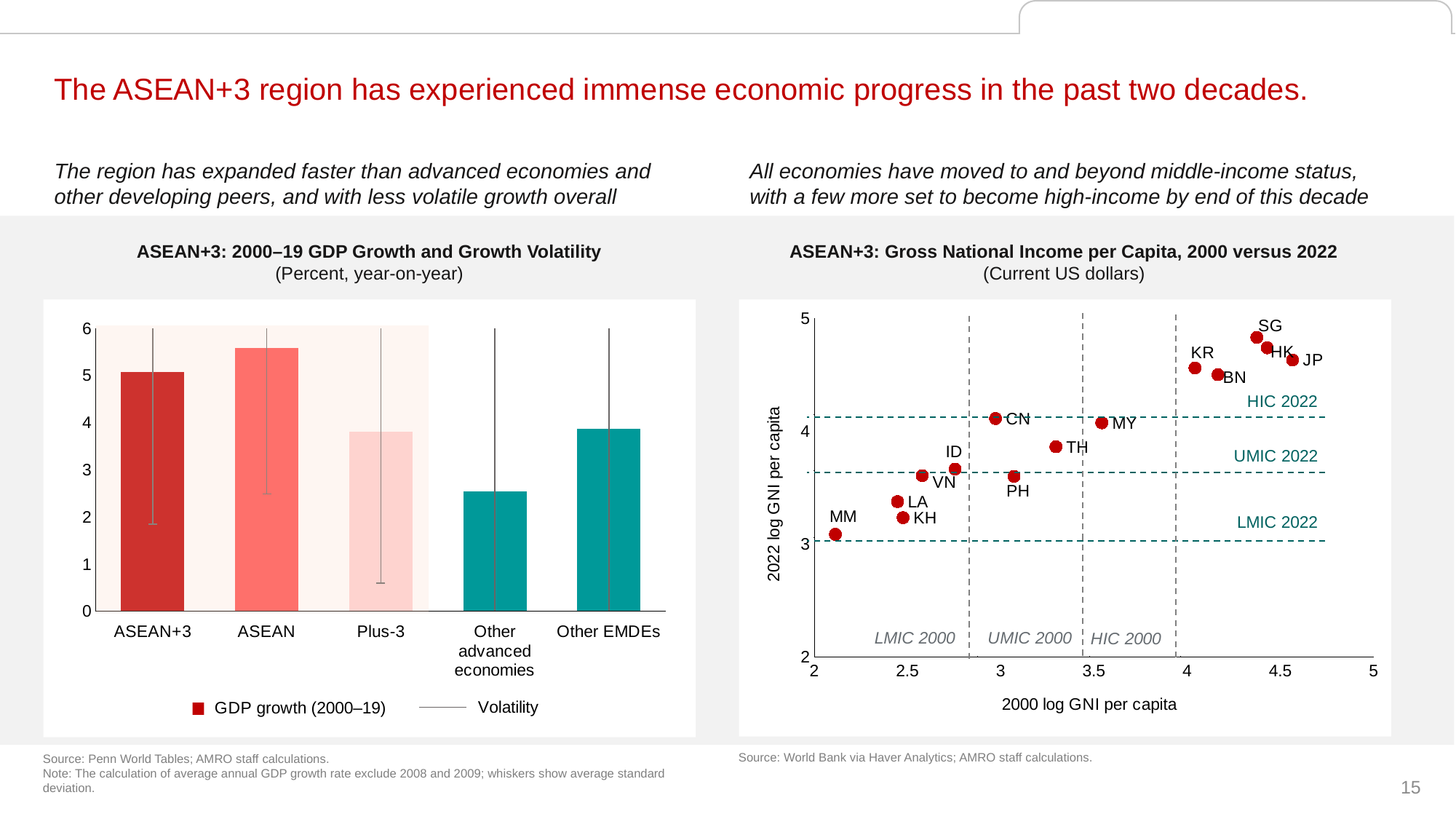
On the right chart, which has the higher 2022 log GNI per capita, CN or PH? CN On the left chart, how many entries does the legend list? 2 On the left chart, is the GDP growth value for ASEAN greater or less than 5? greater On the right chart, how many economies are plotted? 14 On the left chart (ASEAN+3: 2000–19 GDP Growth and Growth Volatility), which category has the lowest GDP growth bar? Other advanced economies On the left chart, how many categories are shown on the x axis? 5 On the right chart (ASEAN+3: Gross National Income per Capita, 2000 versus 2022), which economy has the highest 2022 log GNI per capita? SG On the right chart (ASEAN+3: Gross National Income per Capita, 2000 versus 2022), which economy has the lowest 2022 log GNI per capita? MM What kind of chart is the left chart (ASEAN+3: 2000–19 GDP Growth and Growth Volatility)? Bar chart On the left chart, is the GDP growth value for Other advanced economies greater or less than 3? less On the left chart, is the GDP growth value for Plus-3 greater or less than 4? less On the left chart (ASEAN+3: 2000–19 GDP Growth and Growth Volatility), which category has the highest GDP growth bar? ASEAN